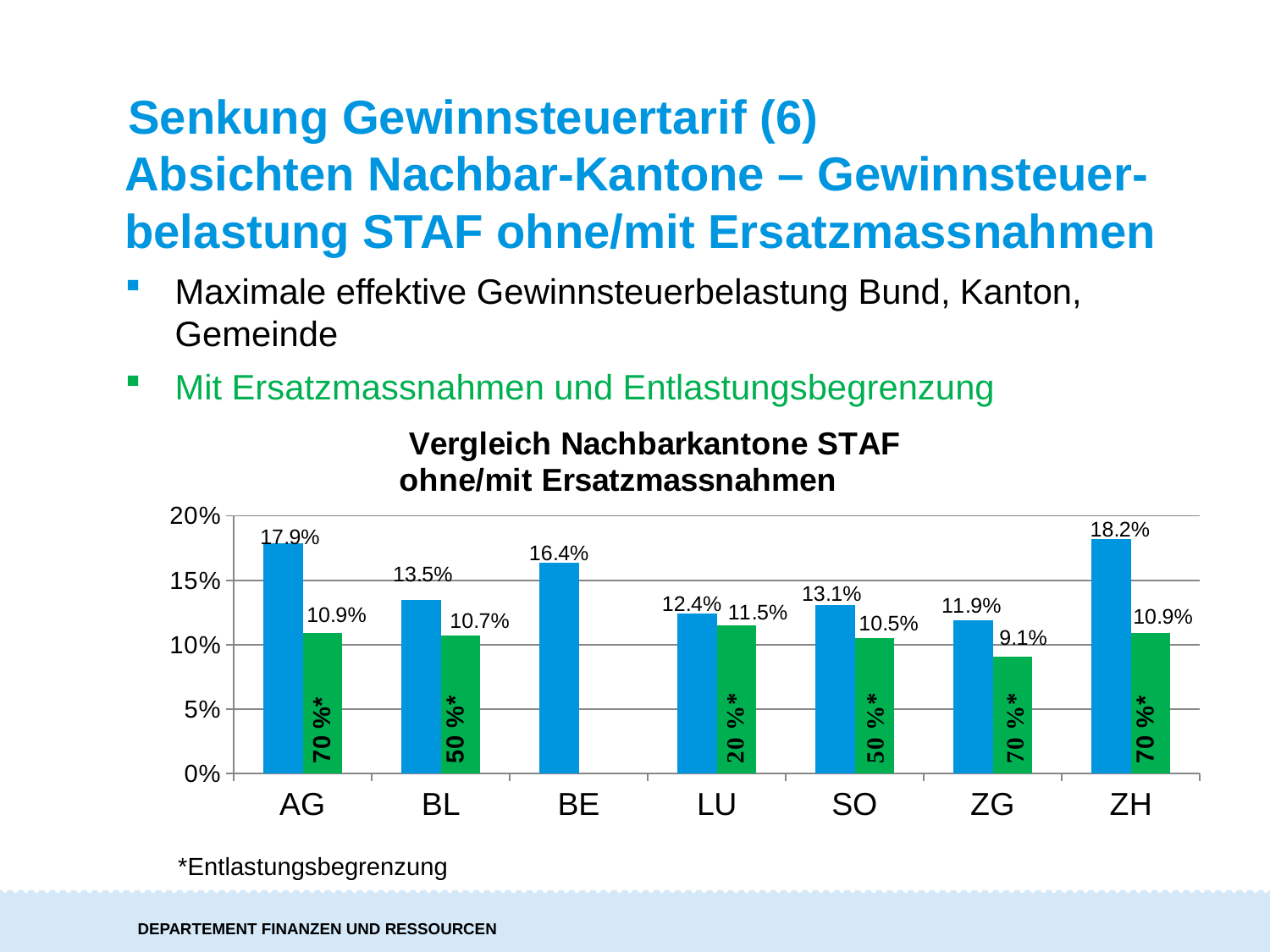
Which canton has no green bar? BE What is the title of the chart? Vergleich Nachbarkantone STAF ohne/mit Ersatzmassnahmen Which canton has the highest blue bar? ZH Which is larger, the blue bar for BL or the blue bar for SO? BL What is the value of the green bar for ZG? 9.1% What Entlastungsbegrenzung percentage is printed on the green bar for LU? 20 %* Which canton has the lowest green bar? ZG How many cantons are shown on the x axis of the chart? 7 What type of chart is shown on the slide? bar chart What is the value of the blue bar for AG? 17.9% What is the difference between the blue and green bars for AG? 7.0% What is the value of the blue bar for BE? 16.4%